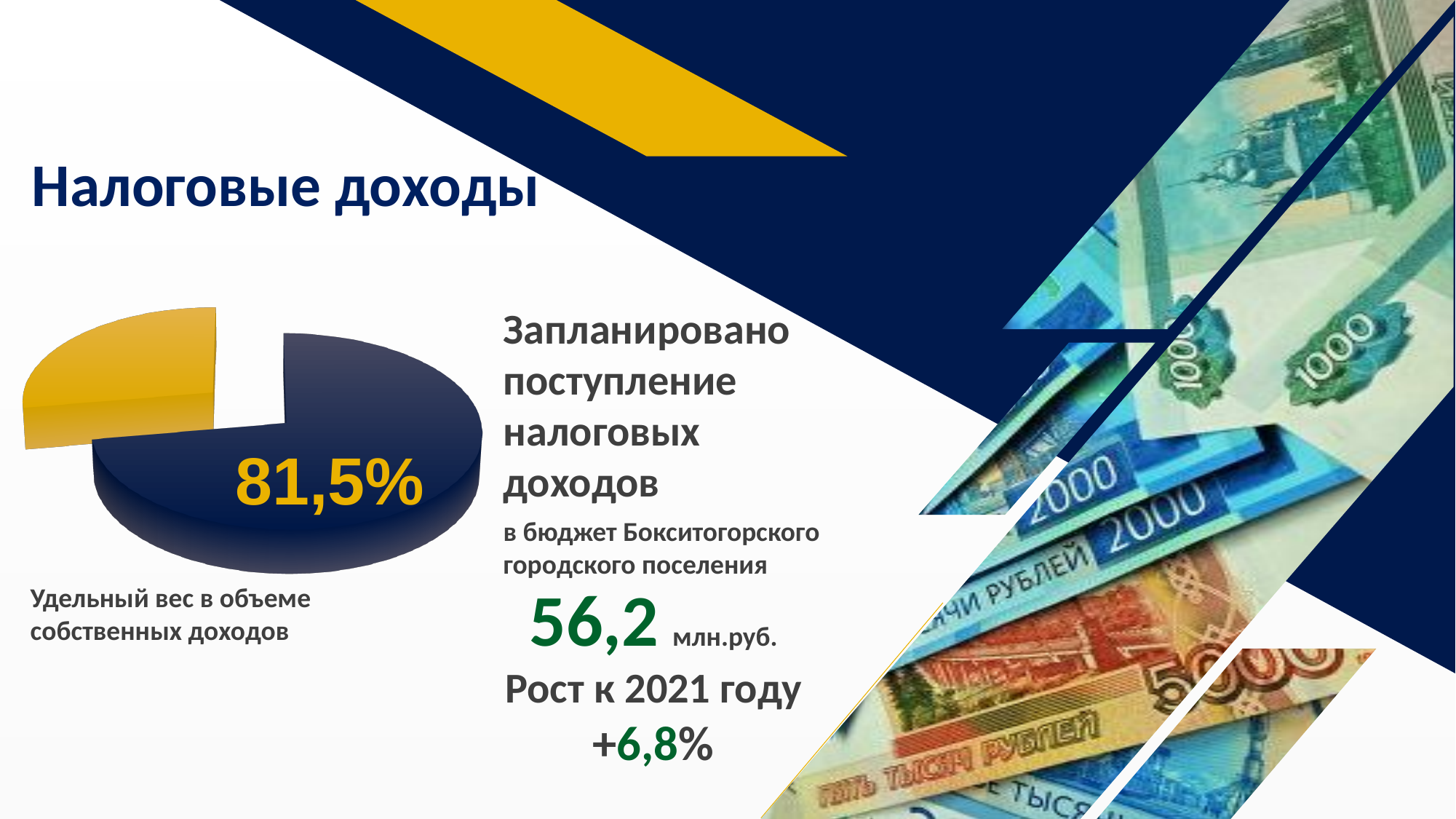
What kind of chart is shown on the slide? Pie chart How many slices does the pie chart have? 2 What percentage is printed on the pie chart? 81,5% What colour is the slice labelled 81,5%? Dark blue What share of the pie does the dark blue slice represent? 81,5% What caption is written below the pie chart? Удельный вес в объеме собственных доходов Which slice of the pie chart is the smallest? The yellow slice Which slice of the pie chart is larger, the dark blue one or the yellow one? The dark blue one